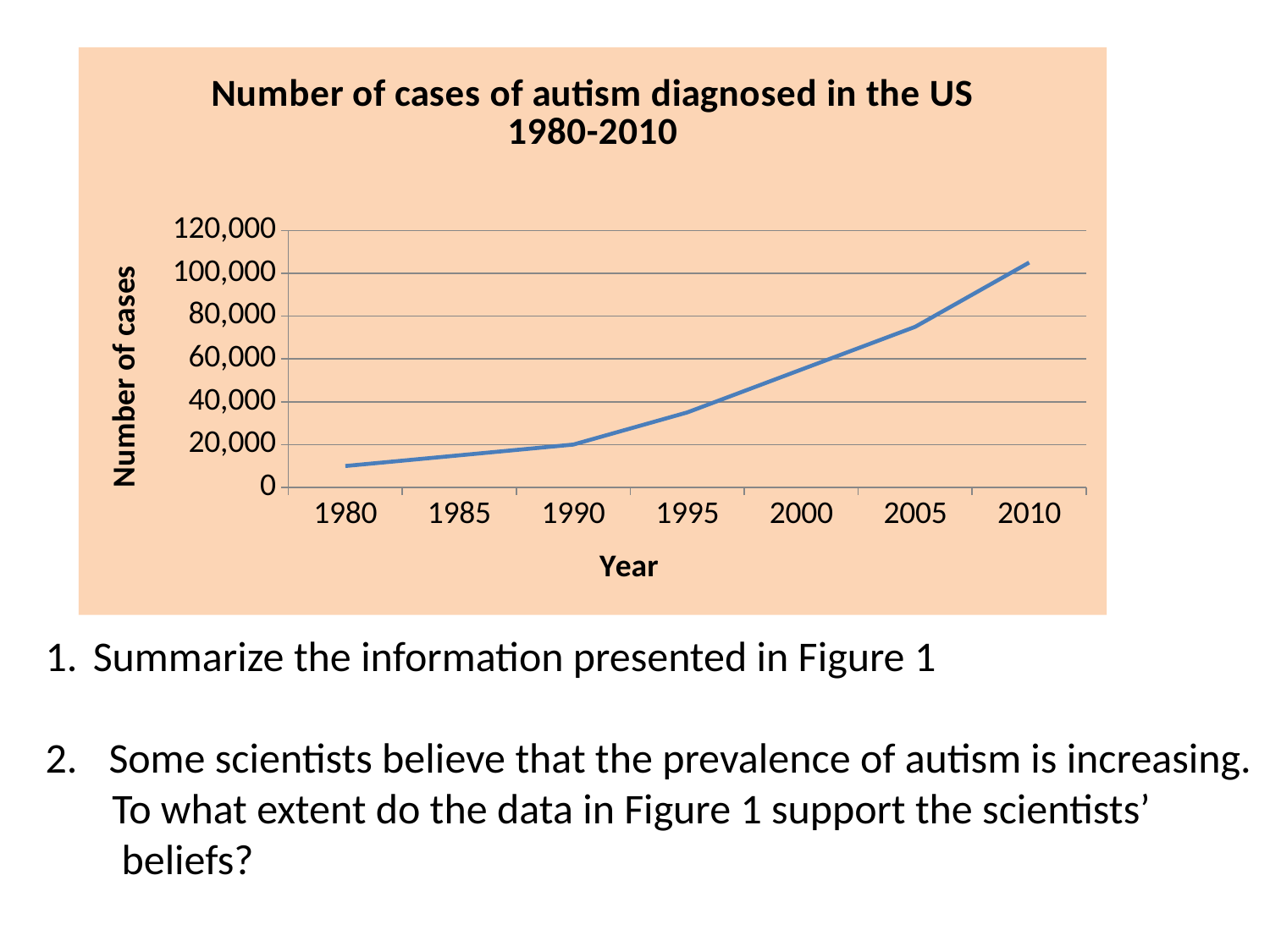
What kind of chart is shown on the slide? line chart Is the number of cases in 1980 greater or less than 20,000? less Is the number of cases in 2010 greater or less than 100,000? greater Is the number of cases in 2000 greater or less than 40,000? greater How many years are marked along the x axis of the chart? 7 Which year has the highest number of cases? 2010 Do the number of cases rise or fall from 1980 to 2010? rise What is the label on the vertical axis of the chart? Number of cases Which year has more cases, 1995 or 2005? 2005 What is the title of the chart? Number of cases of autism diagnosed in the US 1980-2010 Which year has the lowest number of cases? 1980